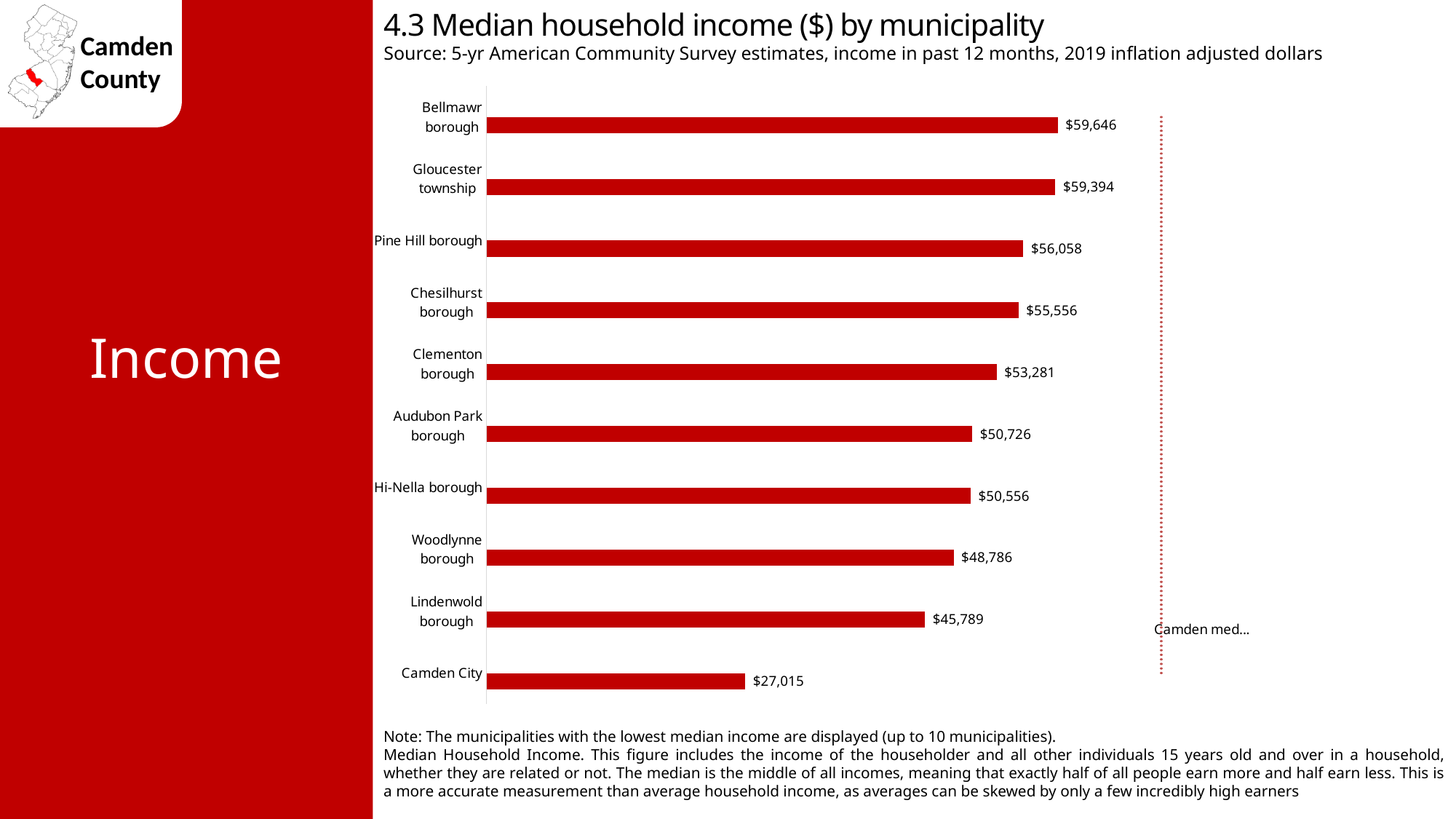
What is the difference in median household income between Bellmawr borough and Camden City? $32,631 How many municipalities are shown on the chart? 10 Which municipality has the highest median household income shown on the chart? Bellmawr borough Do the median household income values increase or decrease going from the top bar to the bottom bar? Decrease What is the median household income for Camden City? $27,015 Which has a higher median household income, Clementon borough or Woodlynne borough? Clementon borough What is the median household income for Lindenwold borough? $45,789 What kind of chart is used to show median household income by municipality? Bar chart Which municipality has the lowest median household income shown on the chart? Camden City What is the median household income for Pine Hill borough? $56,058 What is the difference in median household income between Lindenwold borough and Camden City? $18,774 What is the title of the chart? 4.3 Median household income ($) by municipality